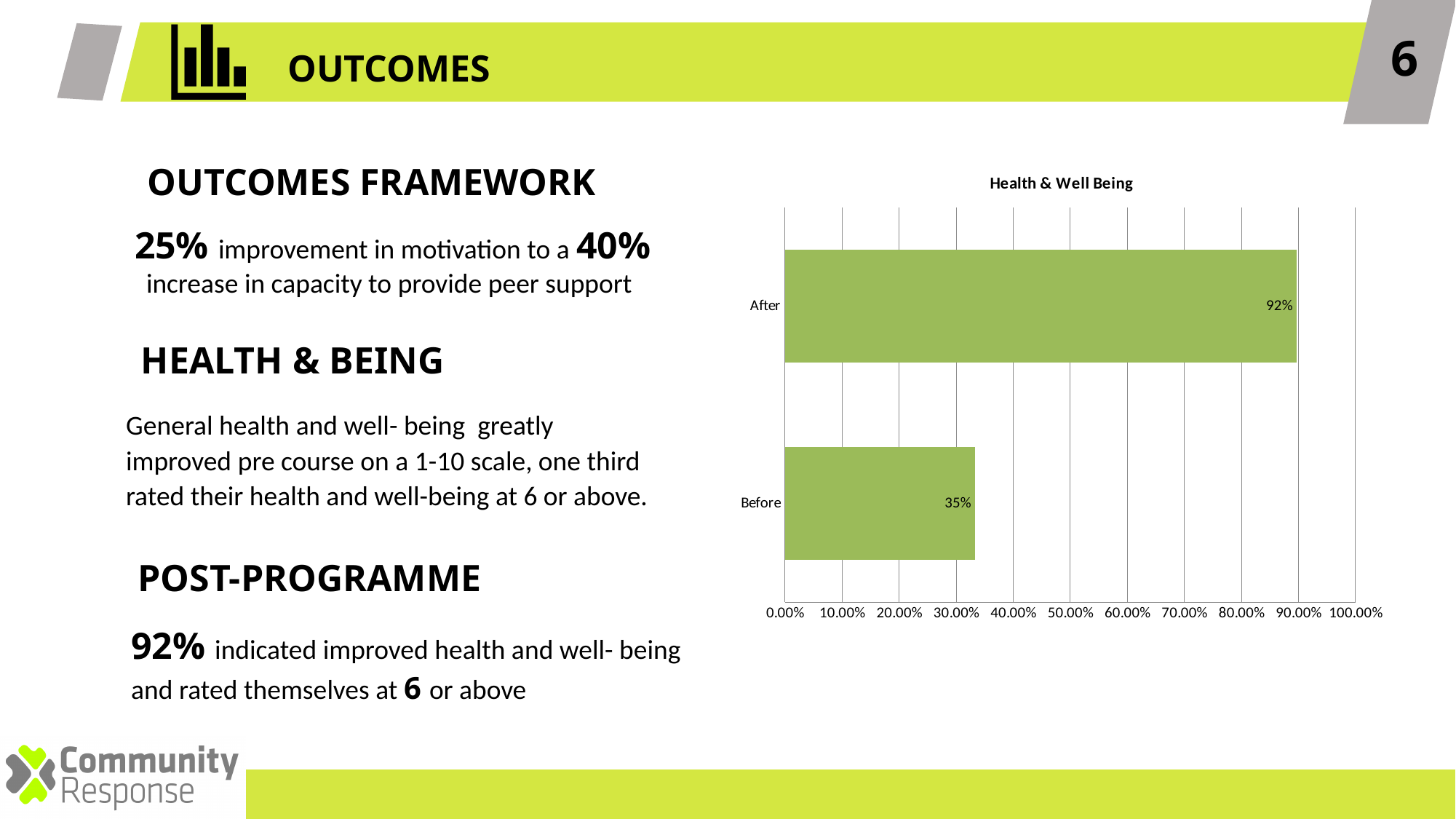
How many categories are shown in the Health & Well Being chart? 2 What is the value for Before in the Health & Well Being chart? 35% What is the maximum value shown on the x axis of the Health & Well Being chart? 100.00% What is the difference between the After and Before values in the Health & Well Being chart? 57% What is the title of the chart on the slide? Health & Well Being Which category has the lowest value in the Health & Well Being chart? Before Which is larger in the Health & Well Being chart, Before or After? After What kind of chart is the Health & Well Being chart? bar chart Which category has the highest value in the Health & Well Being chart? After What is the value for After in the Health & Well Being chart? 92% Is the value for Before greater or less than 50.00% in the Health & Well Being chart? less Is the value for After greater or less than 80.00% in the Health & Well Being chart? greater